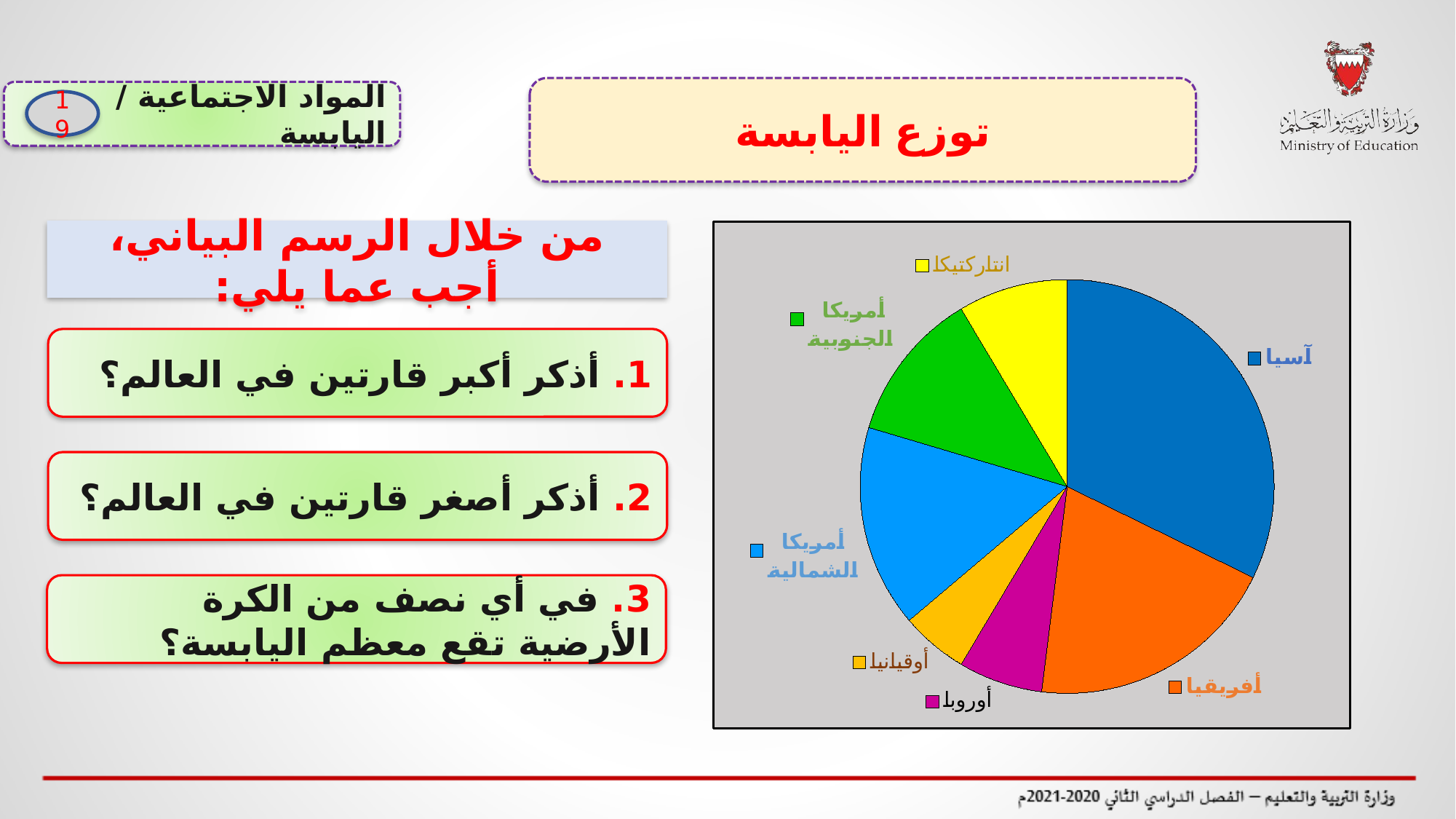
Which slice is larger, آسيا or أفريقيا? آسيا What is the title of the chart shown on the slide? توزع اليابسة Which slice is larger, أفريقيا or أوروبا? أفريقيا What kind of chart is shown on the slide? pie chart How many slices (continents) does the pie chart show? 7 Which slice is larger, أمريكا الشمالية or أمريكا الجنوبية? أمريكا الشمالية Which continent has the largest slice in the pie chart? آسيا What colour is the slice for أفريقيا in the pie chart? orange